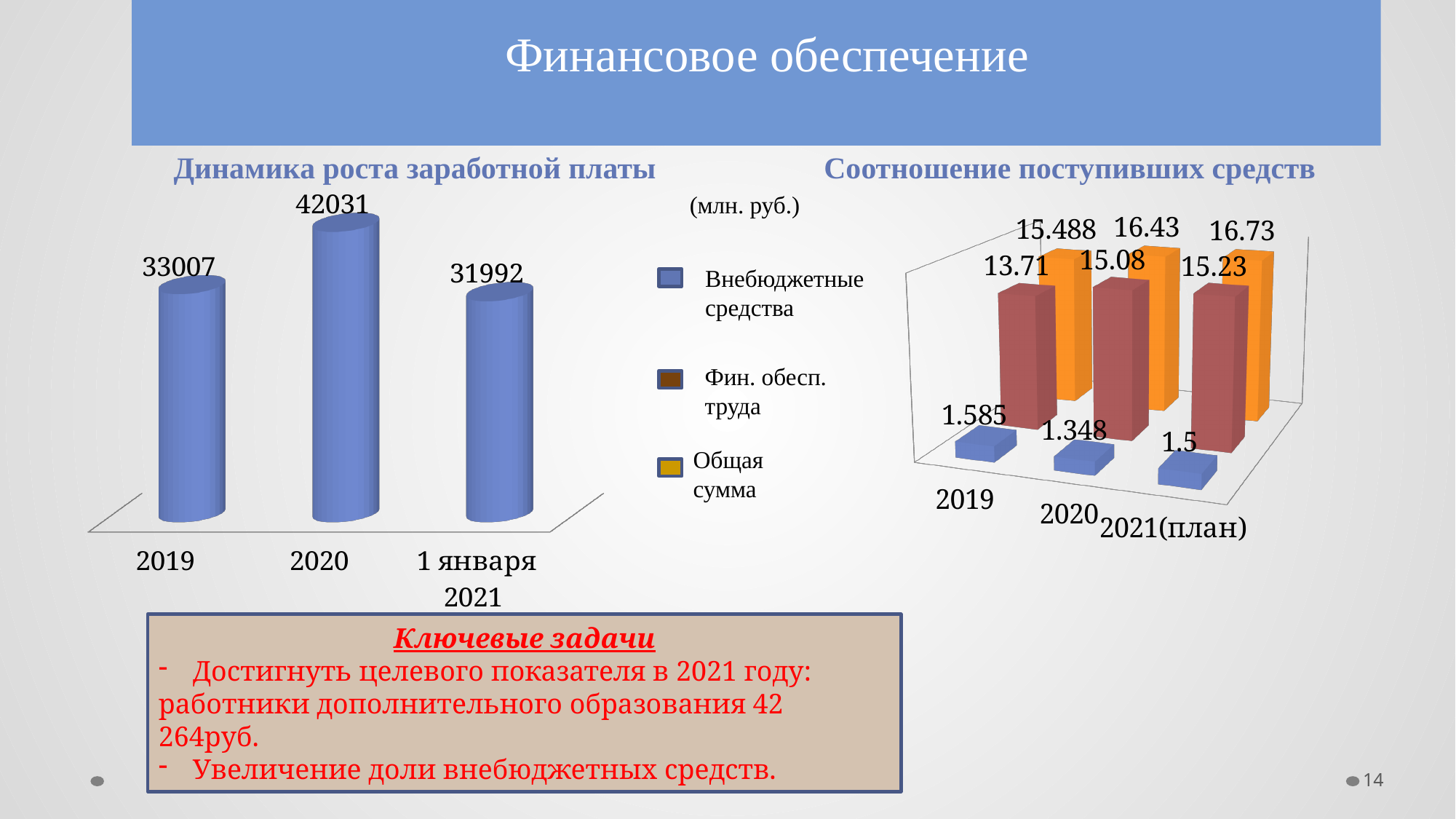
In the chart 'Динамика роста заработной платы', which category has the highest value? 2020 In the chart 'Соотношение поступивших средств', does the Общая сумма series rise or fall from 2019 to 2021(план)? rise In the chart 'Динамика роста заработной платы', what is the value for 1 января 2021? 31992 In the chart 'Динамика роста заработной платы', which category has the lowest value? 1 января 2021 What kind of chart is 'Соотношение поступивших средств'? bar chart In the chart 'Соотношение поступивших средств', what is the value of Внебюджетные средства for 2019? 1.585 In the chart 'Соотношение поступивших средств', what is the value of Фин. обесп. труда for 2020? 15.08 In the chart 'Соотношение поступивших средств', how many series does the legend list? 3 In the chart 'Динамика роста заработной платы', how many bars are plotted? 3 In the chart 'Соотношение поступивших средств', what is the value of Общая сумма for 2021(план)? 16.73 In the chart 'Динамика роста заработной платы', what is the value for 2020? 42031 In the chart 'Динамика роста заработной платы', what is the difference between the values for 2020 and 2019? 9024